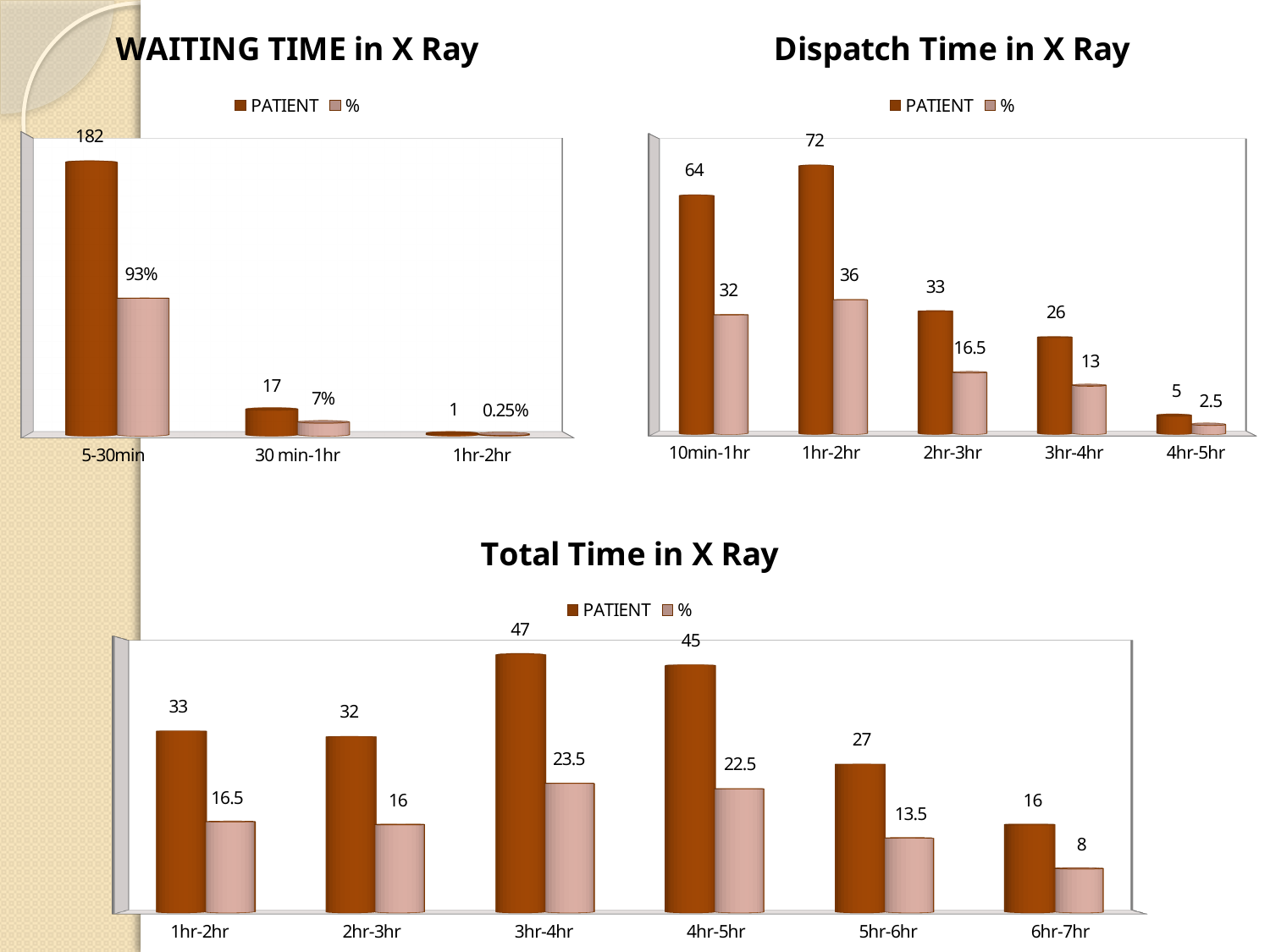
In the 'Dispatch Time in X Ray' chart, which category has the highest PATIENT value? 1hr-2hr In the 'WAITING TIME in X Ray' chart, which category has the lowest PATIENT value? 1hr-2hr In the 'Total Time in X Ray' chart, which category has the highest PATIENT value? 3hr-4hr In the 'Dispatch Time in X Ray' chart, what is the PATIENT value for 2hr-3hr? 33 In the 'Total Time in X Ray' chart, is the PATIENT value for 1hr-2hr or 5hr-6hr larger? 1hr-2hr How many categories are shown in the 'Dispatch Time in X Ray' chart? 5 In the 'Dispatch Time in X Ray' chart, what is the difference between the PATIENT values for 1hr-2hr and 10min-1hr? 8 How many series does the legend of the 'Total Time in X Ray' chart list? 2 What kind of chart is the 'Total Time in X Ray' chart? bar chart In the 'WAITING TIME in X Ray' chart, what is the PATIENT value for 5-30min? 182 In the 'Total Time in X Ray' chart, what is the % value for 5hr-6hr? 13.5 In the 'WAITING TIME in X Ray' chart, what is the % value for 30 min-1hr? 7%